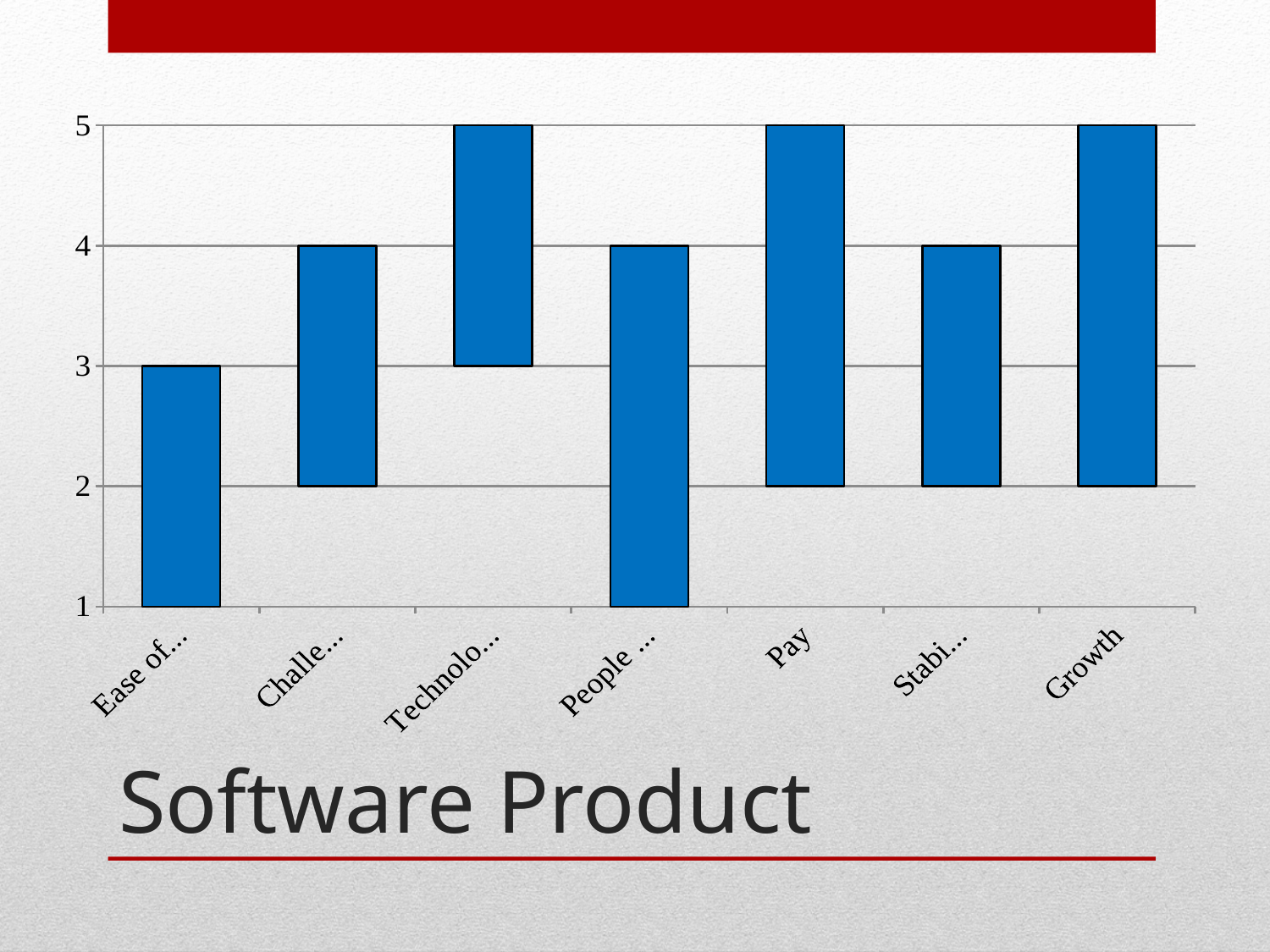
What value does the bottom of the Growth bar start at? 2 Do the Pay and Growth bars reach the same top value? yes Is the top of the Pay bar greater or less than 4? greater How many bars are plotted in the chart? 7 How many units does the Pay bar span from its bottom to its top? 3 What value does the bottom of the Pay bar start at? 2 What value does the top of the Growth bar reach? 5 What is the title text shown below the chart? Software Product What kind of chart is shown on the slide? bar chart What is the highest value shown on the vertical axis? 5 What value does the top of the Pay bar reach? 5